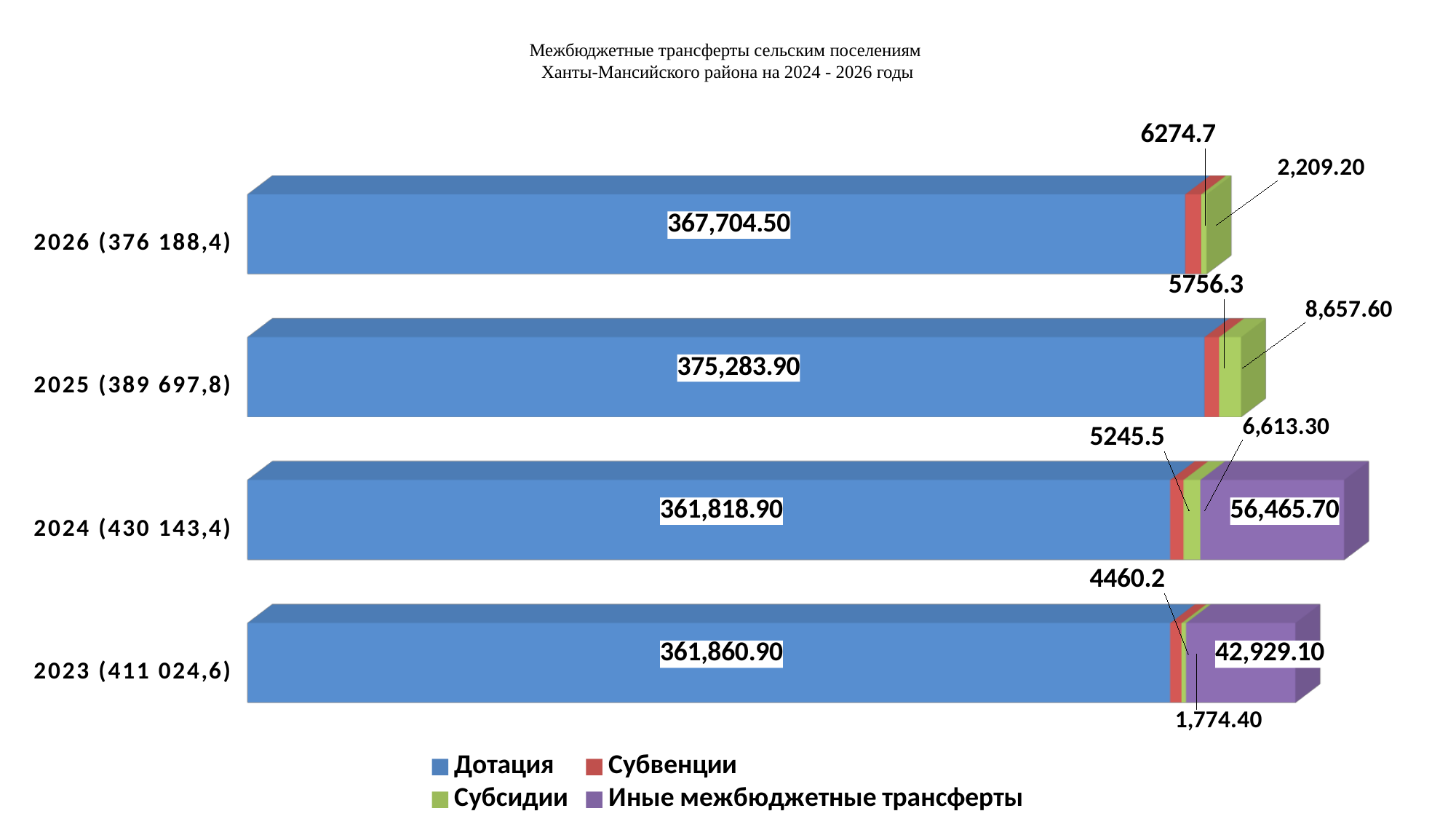
How many series does the legend list? 4 Which is larger: Субсидии for 2025 or Субсидии for 2024? Субсидии for 2025 In which year is the Дотация value the highest? 2025 (389 697,8) In which year is the Субсидии value the lowest? 2023 (411 024,6) What kind of chart is shown on the slide? Stacked bar chart What is the value of Дотация for 2025 (389 697,8)? 375,283.90 What is the value of Иные межбюджетные трансферты for 2024 (430 143,4)? 56,465.70 How many years (categories) are shown on the chart? 4 What is the difference between the Иные межбюджетные трансферты values for 2024 and 2023? 13,536.60 What is the value of Субвенции for 2026 (376 188,4)? 6274.7 Which series is shown in purple in the legend? Иные межбюджетные трансферты What is the value of Субсидии for 2023 (411 024,6)? 1,774.40